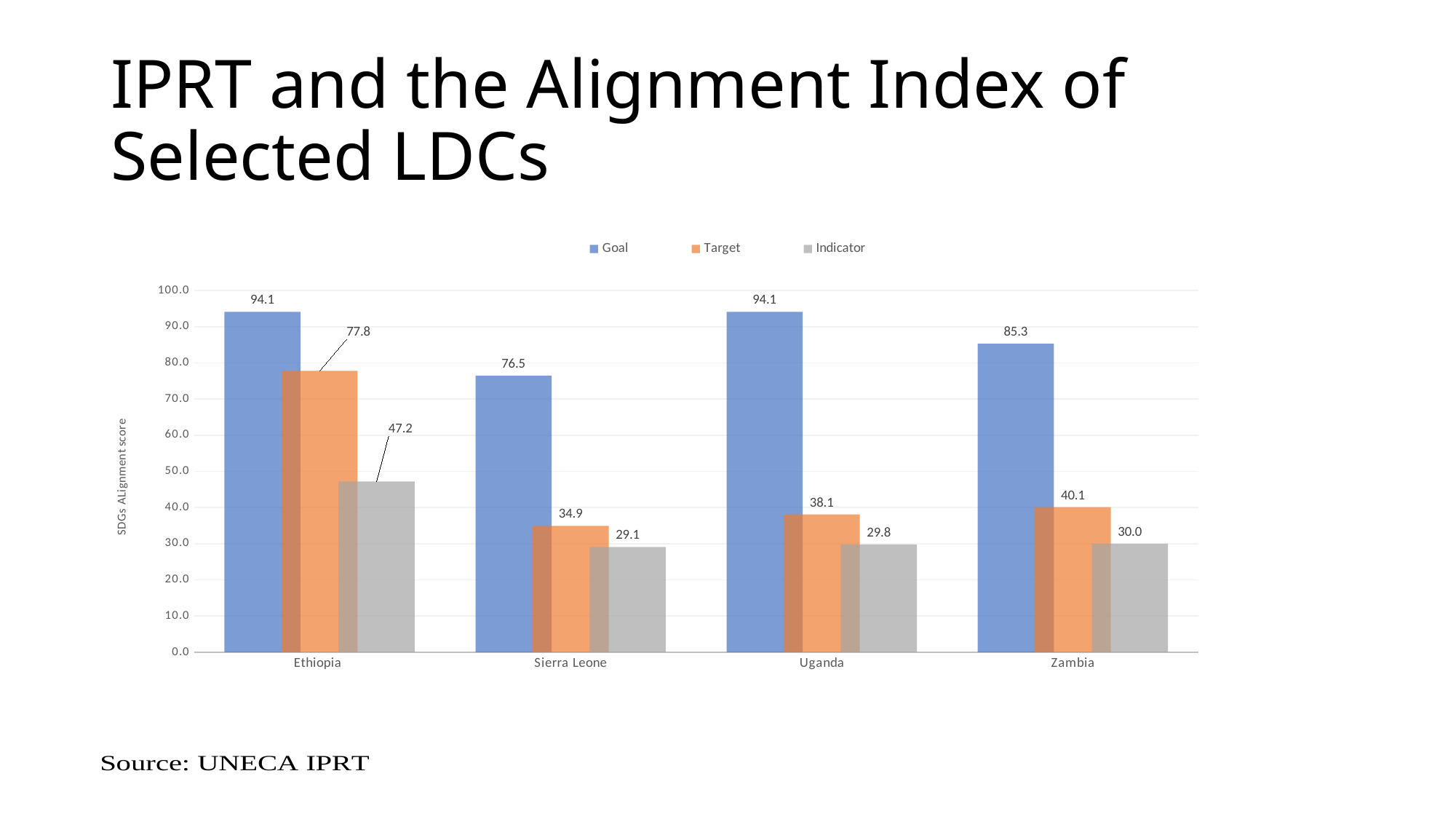
How many series does the legend list? 3 Which country has the lowest Goal value? Sierra Leone What is the Target value for Ethiopia? 77.8 Which country has the highest Target value? Ethiopia What is the difference between the Goal and Target values for Uganda? 56.0 How many countries are shown on the x axis? 4 What is the label of the vertical axis? SDGs ALignment score What kind of chart is shown on the slide? Bar chart What is the Goal value for Sierra Leone? 76.5 What is the Indicator value for Uganda? 29.8 Which is larger, the Indicator value for Ethiopia or the Indicator value for Zambia? Ethiopia What is the Target value for Zambia? 40.1